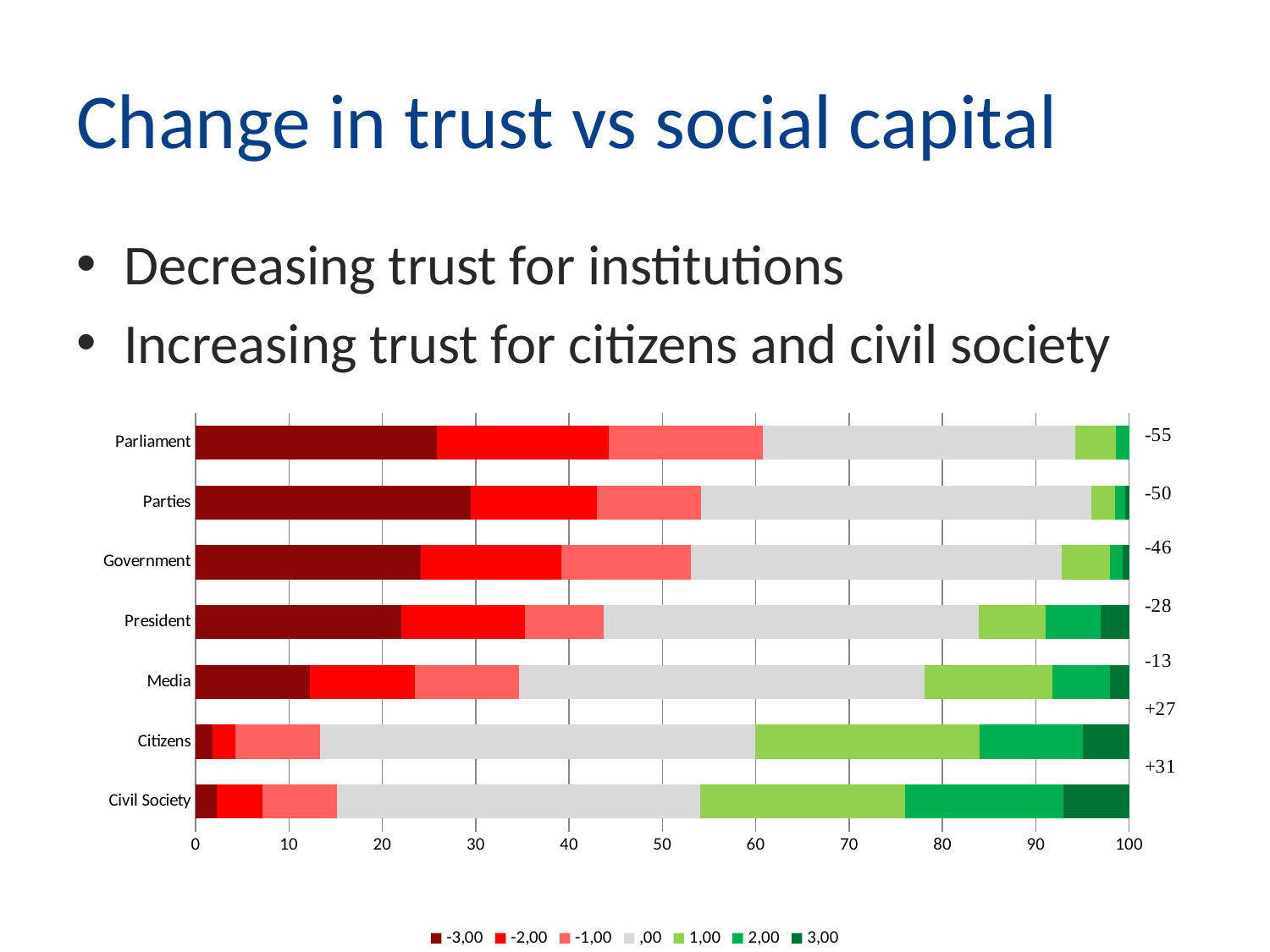
Is the -3,00 segment for Parliament greater or less than 20? greater What net change value is printed next to the Media bar? -13 Which is larger, the 1,00 segment for Civil Society or the 1,00 segment for Parliament? Civil Society What net change value is printed next to the Civil Society bar? +31 How many categories are plotted on the chart? 7 What is the title of the slide containing the chart? Change in trust vs social capital How many series does the chart legend list? 7 What kind of chart is shown on the slide? Stacked bar chart Which category has the lowest net change value printed beside its bar? Parliament What net change value is printed next to the Parliament bar? -55 What is the difference between the net change values printed for Civil Society and Parliament? 86 Which category has the highest net change value printed beside its bar? Civil Society